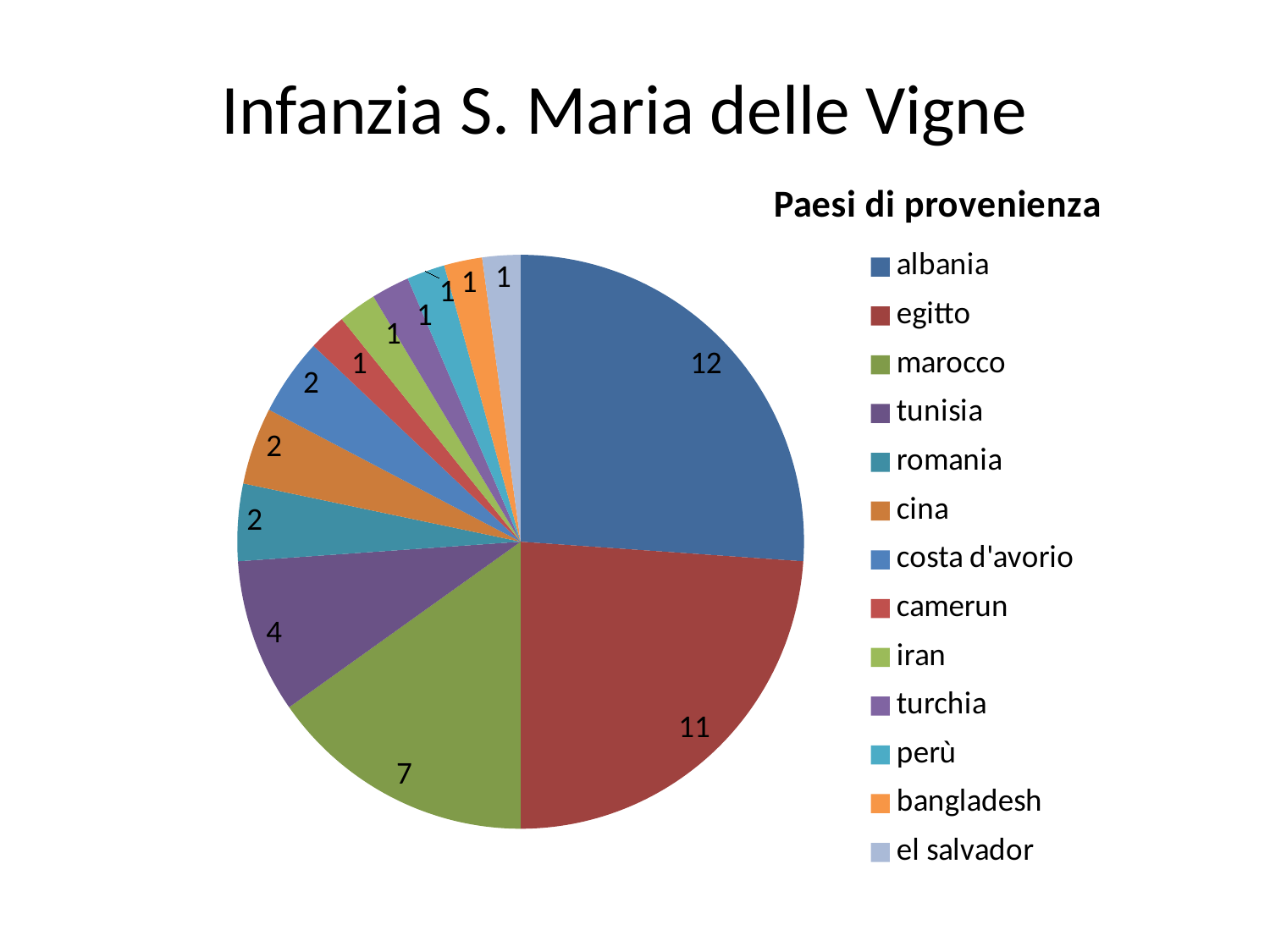
Which country has the largest slice in the pie chart? albania What is the value for egitto in the pie chart? 11 What kind of chart is shown on the slide? pie chart Which is larger, the value for marocco or the value for tunisia? marocco What is the value for marocco in the pie chart? 7 What is the value for albania in the pie chart? 12 What is the difference between the values for albania and marocco? 5 What is the difference between the values for egitto and tunisia? 7 Which is larger, the value for albania or the value for egitto? albania What is the title of the chart? Paesi di provenienza What is the value for tunisia in the pie chart? 4 How many countries are shown in the pie chart? 13